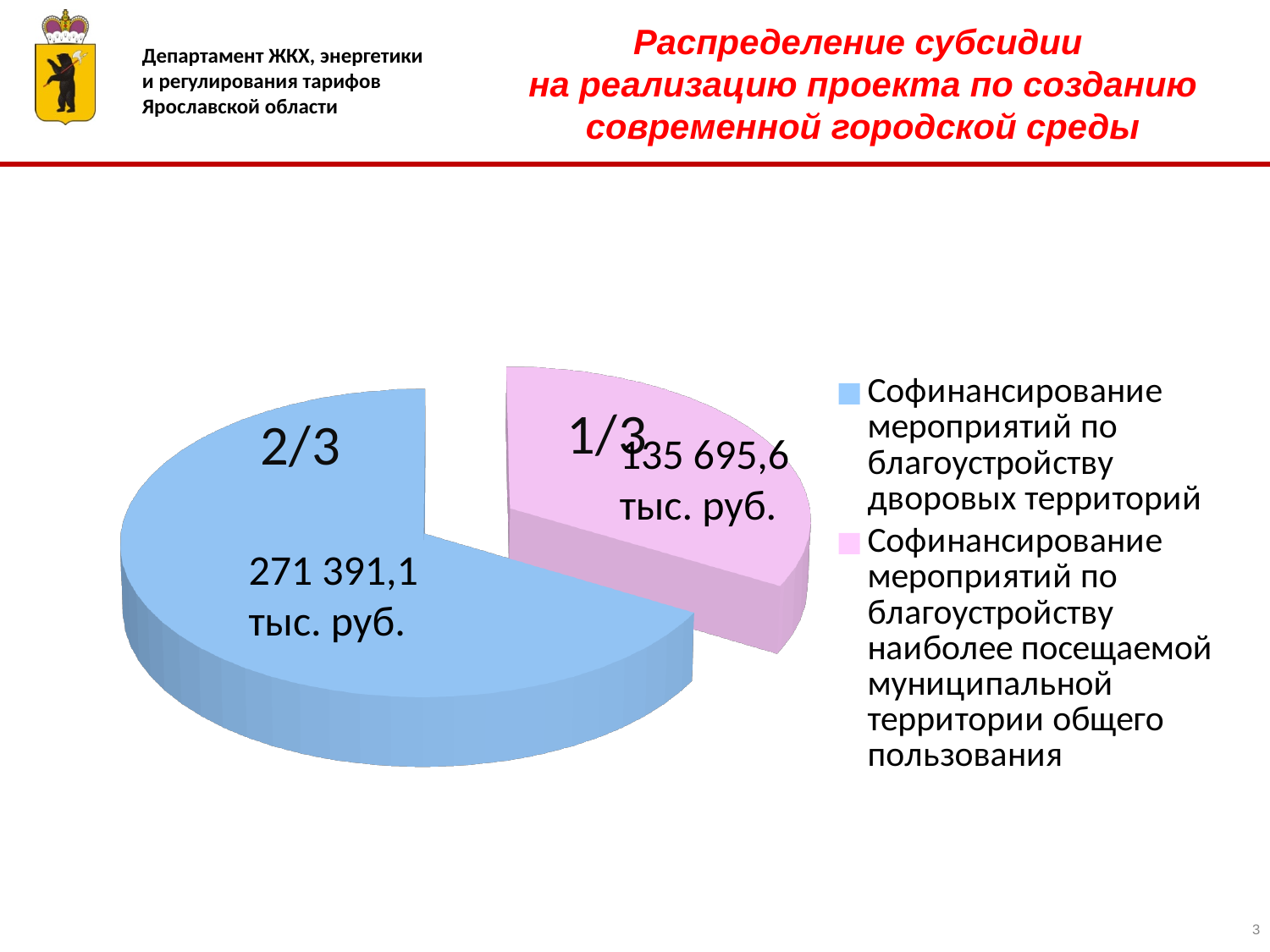
Which slice of the pie is the largest? Софинансирование мероприятий по благоустройству дворовых территорий What value is shown for the slice "Софинансирование мероприятий по благоустройству дворовых территорий"? 271 391,1 тыс. руб. What share of the pie does the slice for благоустройство дворовых территорий represent? 2/3 What share of the pie does the slice for благоустройство наиболее посещаемой муниципальной территории общего пользования represent? 1/3 What value is shown for the slice "Софинансирование мероприятий по благоустройству наиболее посещаемой муниципальной территории общего пользования"? 135 695,6 тыс. руб. What is the total of the two values shown on the pie chart? 407 086,7 тыс. руб. Which slice of the pie is the smallest? Софинансирование мероприятий по благоустройству наиболее посещаемой муниципальной территории общего пользования How many entries does the legend list? 2 What kind of chart is shown on the slide? Pie chart How many slices does the pie chart have? 2 What colour is the slice for "Софинансирование мероприятий по благоустройству дворовых территорий"? Blue What is the difference between the value for дворовых территорий and the value for наиболее посещаемой муниципальной территории общего пользования? 135 695,5 тыс. руб.